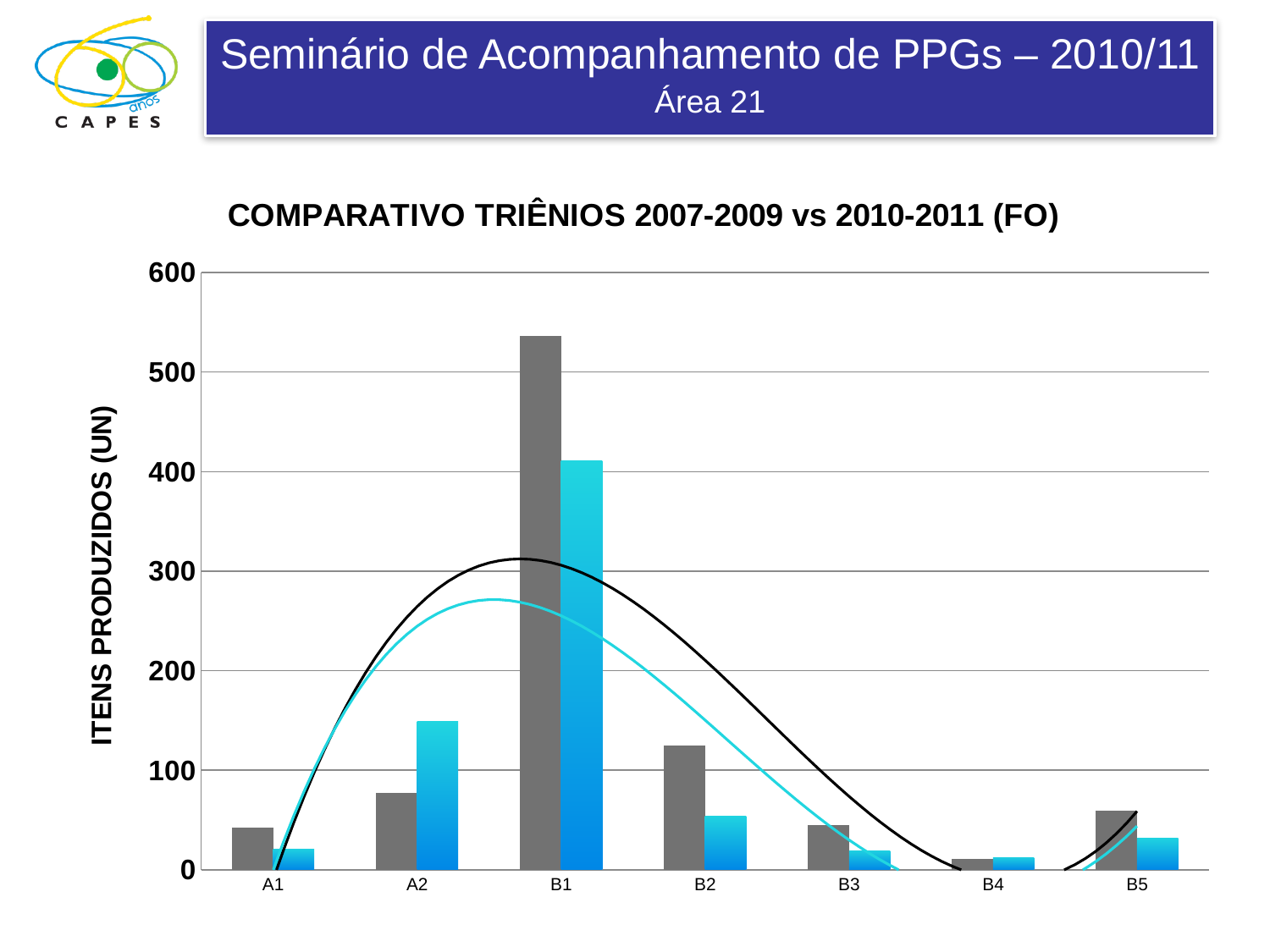
Is the value of the blue bar for B1 greater or less than 500? less Is the value of the blue bar for A2 greater or less than 100? greater Which category has the highest gray bar? B1 Which category has the lowest gray bar? B4 How many categories are shown on the x axis of the chart? 7 What kind of chart is shown on the slide? bar chart What is the title of the chart? COMPARATIVO TRIÊNIOS 2007-2009 vs 2010-2011 (FO) Is the value of the gray bar for B1 greater or less than 500? greater Which category has the highest blue bar? B1 For category A2, which bar is larger, the gray bar or the blue bar? the blue bar For category B2, which bar is larger, the gray bar or the blue bar? the gray bar